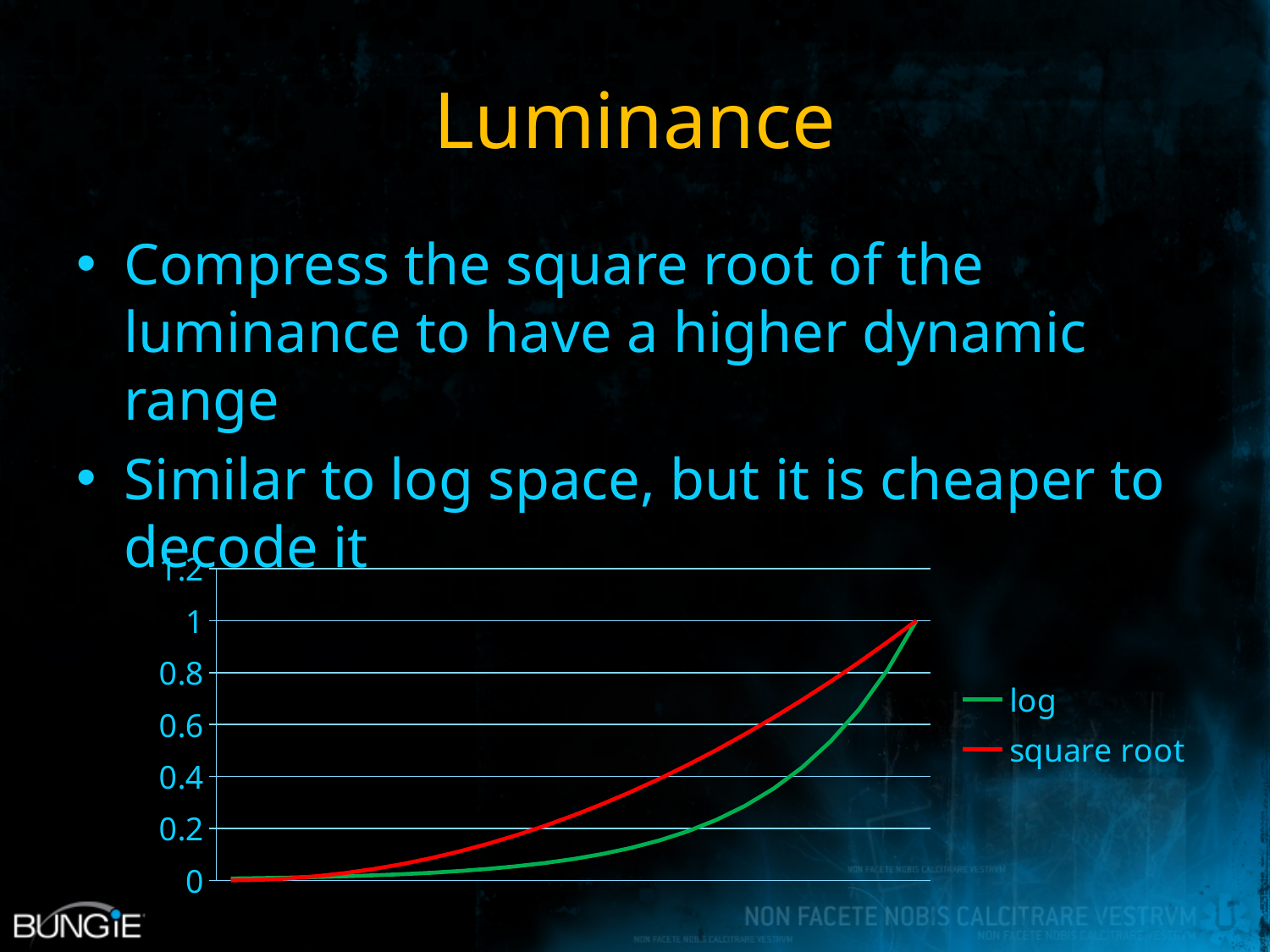
What value do both curves reach at the right end of the x axis? 1 What is the highest tick value shown on the y axis? 1.2 Is the value of the log series at the middle of the x axis greater or less than 0.4? less Do the values of the square root series rise or fall from left to right along the x axis? rise Which series is higher in the middle of the x axis, log or square root? square root How many series does the chart's legend list? 2 What are the two series named in the chart's legend? log and square root What kind of chart is shown on the slide? line chart Which series stays lower across most of the x axis, log or square root? log Which colour is used for the square root series? red Do the values of the log series rise or fall from left to right along the x axis? rise